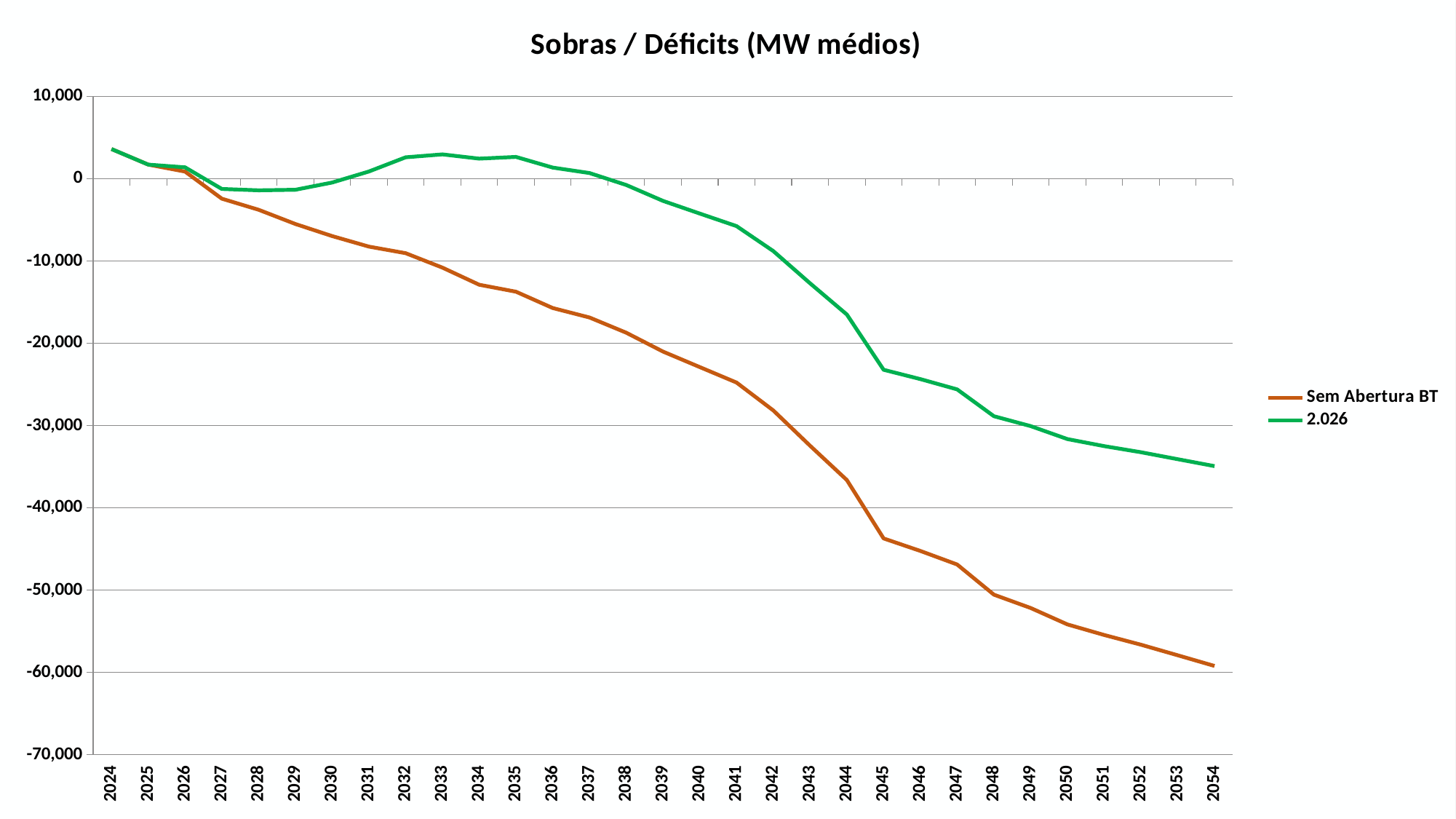
How many years are plotted along the x axis? 31 In 2045, which series has the higher value, Sem Abertura BT or 2.026? 2.026 Does the Sem Abertura BT series rise or fall from 2024 to 2054? fall Is the value for Sem Abertura BT in 2030 greater or less than -10,000? greater Is the value for Sem Abertura BT in 2041 greater or less than -20,000? less Is the value for 2.026 in 2054 greater or less than -30,000? less How many series does the legend list? 2 What is the title of the chart? Sobras / Déficits (MW médios) What colour is the line for the series 2.026? green What kind of chart is shown on the slide? line chart